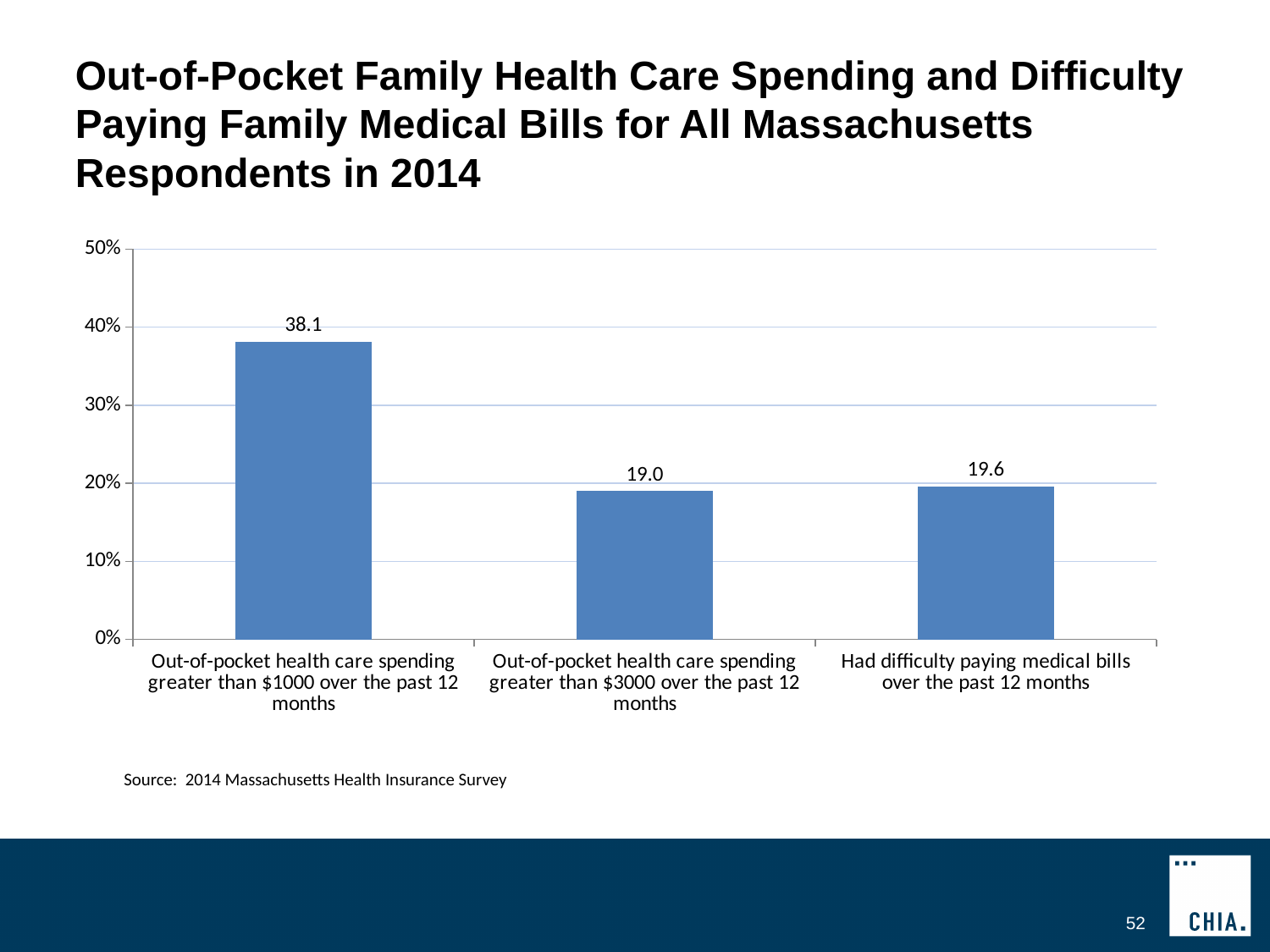
Which category has the highest value? Out-of-pocket health care spending greater than $1000 over the past 12 months What is the value for out-of-pocket health care spending greater than $3000 over the past 12 months? 19.0 What is the source cited below the chart? 2014 Massachusetts Health Insurance Survey How many categories are shown in the chart? 3 What is the difference between the value for spending greater than $1000 and the value for spending greater than $3000? 19.1 What is the value for had difficulty paying medical bills over the past 12 months? 19.6 What kind of chart is shown on the slide? Bar chart Is the value for out-of-pocket health care spending greater than $1000 greater or less than 30%? greater Which is larger: the value for spending greater than $1000 or the value for had difficulty paying medical bills? Spending greater than $1000 Which category has the lowest value? Out-of-pocket health care spending greater than $3000 over the past 12 months What is the value for out-of-pocket health care spending greater than $1000 over the past 12 months? 38.1 What is the difference between the value for had difficulty paying medical bills and the value for spending greater than $3000? 0.6